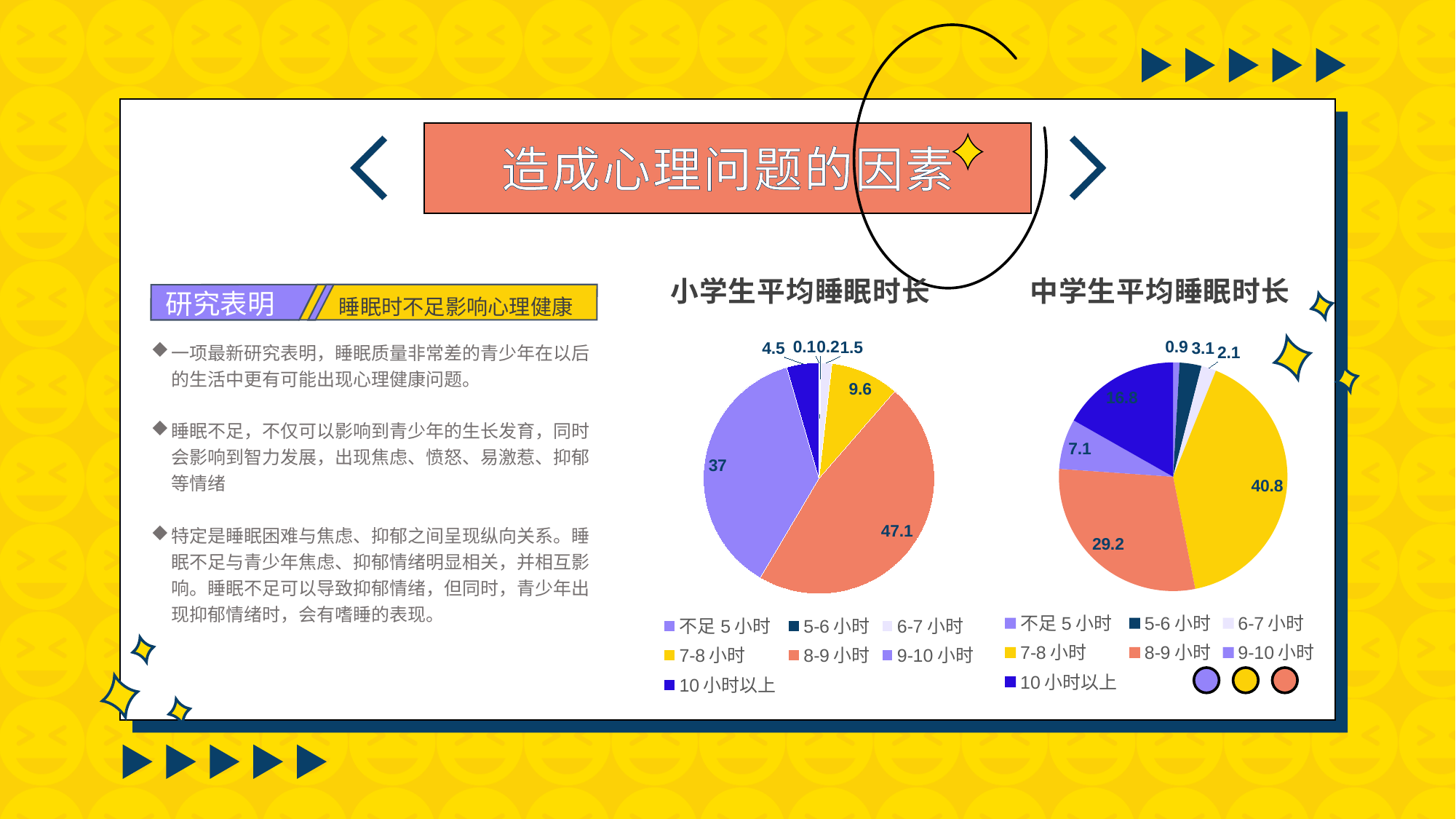
Which is larger: the 10 小时以上 value in the 小学生平均睡眠时长 chart or in the 中学生平均睡眠时长 chart? 中学生平均睡眠时长 In the 小学生平均睡眠时长 chart, which category has the smallest slice? 不足 5 小时 In the 中学生平均睡眠时长 chart, what is the difference between the values for 7-8 小时 and 8-9 小时? 11.6 In the 小学生平均睡眠时长 chart, which category has the largest slice? 8-9 小时 In the 中学生平均睡眠时长 chart, which category has the largest slice? 7-8 小时 In the 小学生平均睡眠时长 chart, what is the difference between the values for 8-9 小时 and 9-10 小时? 10.1 In the 小学生平均睡眠时长 chart, what is the value for 8-9 小时? 47.1 In the 中学生平均睡眠时长 chart, what is the value for 10 小时以上? 16.8 How many categories does the legend of the 小学生平均睡眠时长 chart list? 7 In the 中学生平均睡眠时长 chart, what is the value for 7-8 小时? 40.8 What type of charts are shown on the slide? Pie charts In the 小学生平均睡眠时长 chart, what is the value for 9-10 小时? 37